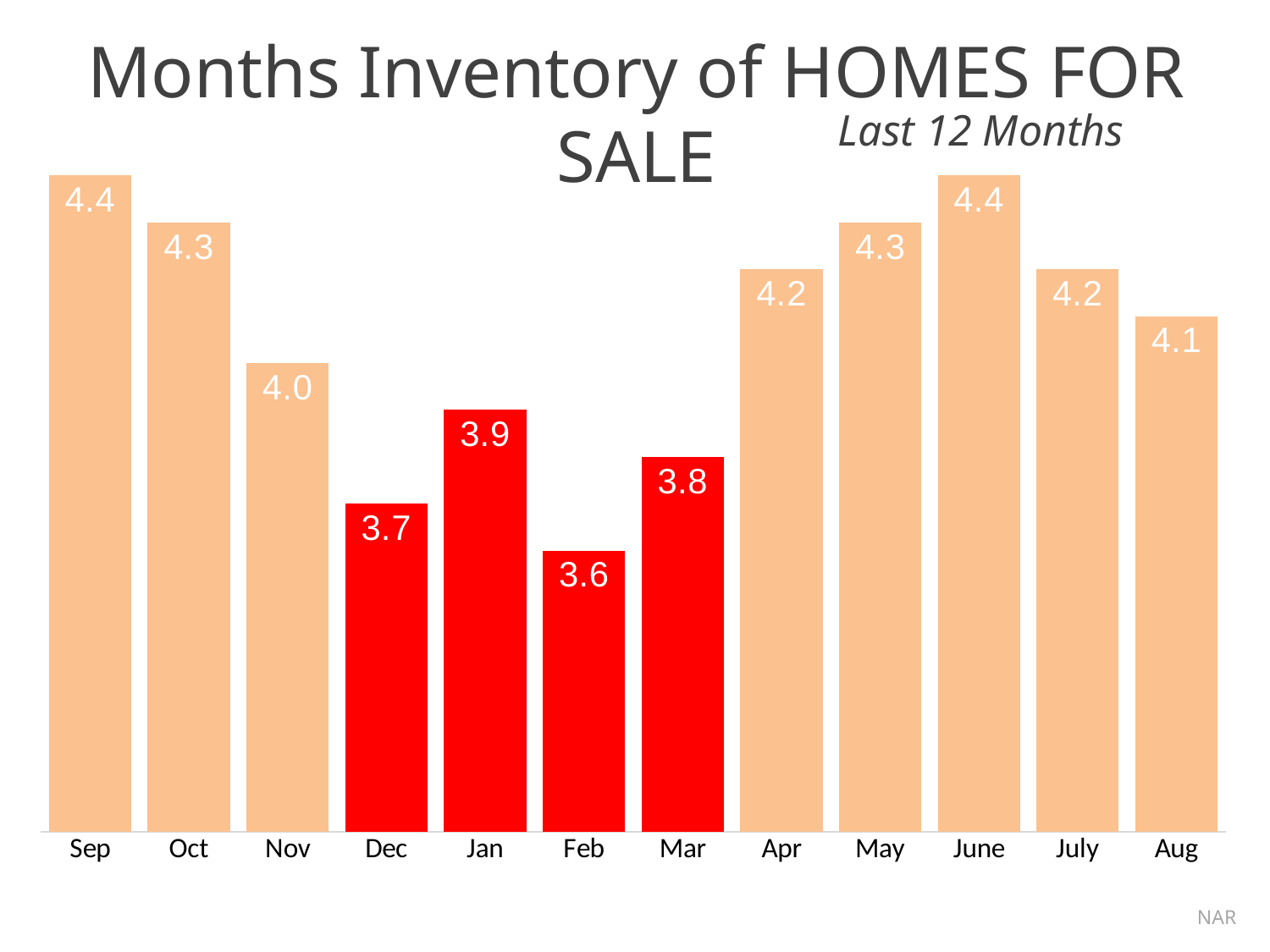
What is the months inventory value for Nov? 4.0 How many months are shown on the chart? 12 What is the months inventory value for Feb? 3.6 Do the values rise or fall from Mar to June? Rise Which months are shown with red bars? Dec, Jan, Feb, Mar Which is larger, the value for Oct or the value for Nov? Oct What is the months inventory value for Aug? 4.1 What kind of chart is shown on the slide? Bar chart What is the difference between the values for Sep and Feb? 0.8 Which month has the lowest months inventory of homes for sale? Feb Which is larger, the value for Mar or the value for Apr? Apr What is the difference between the values for Jan and Dec? 0.2